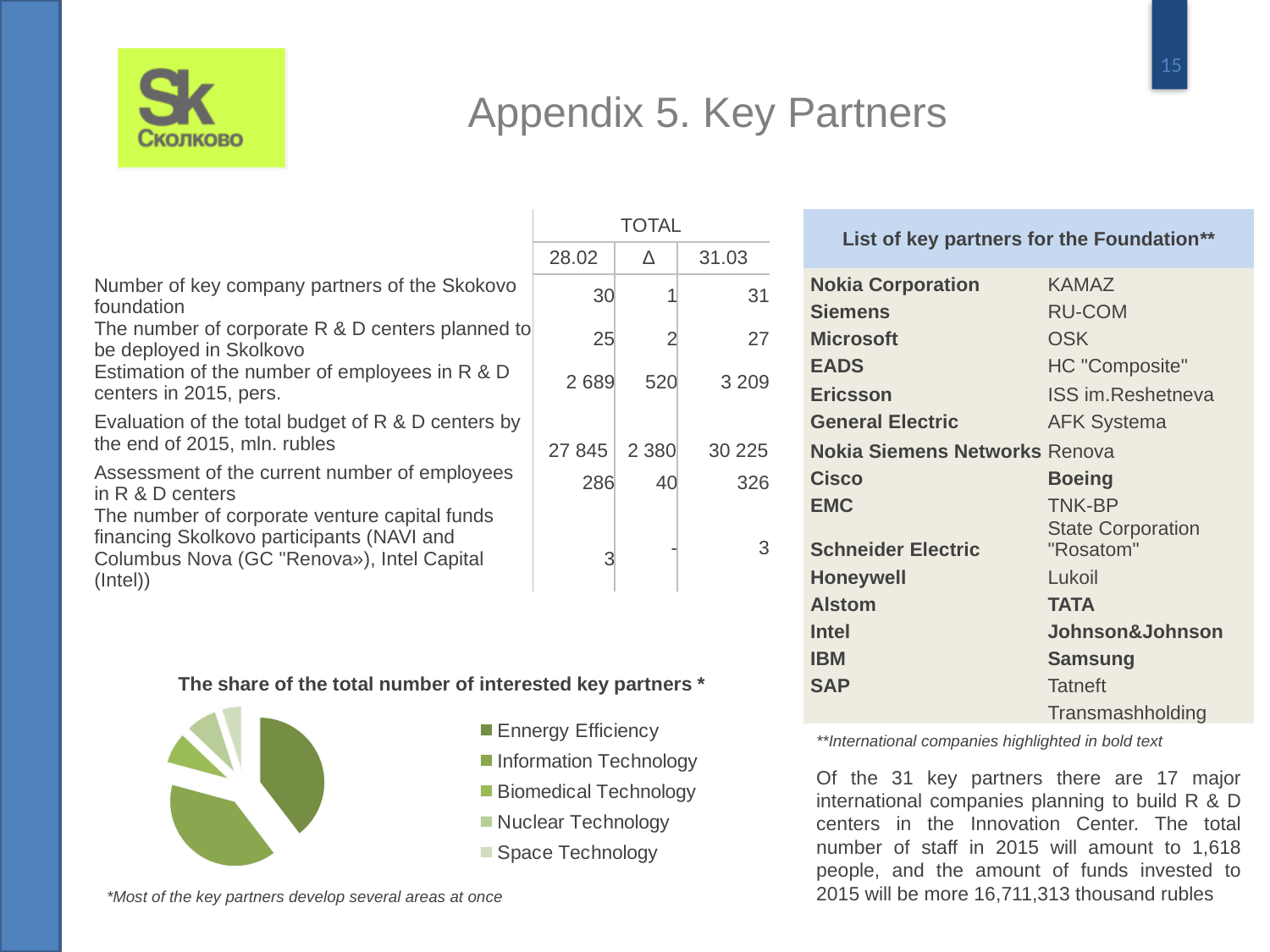
What kind of chart is shown at the bottom left of the slide? pie chart How many entries does the legend of the pie chart list? 5 Which legend entry is listed first in the pie chart's legend? Ennergy Efficiency How many slices does the pie chart have? 5 In the pie chart, which slice is larger: Information Technology or Biomedical Technology? Information Technology What is the title of the pie chart on the slide? The share of the total number of interested key partners * In the pie chart, which slice is larger: Information Technology or Nuclear Technology? Information Technology In the pie chart, which slice is larger: Ennergy Efficiency or Nuclear Technology? Ennergy Efficiency